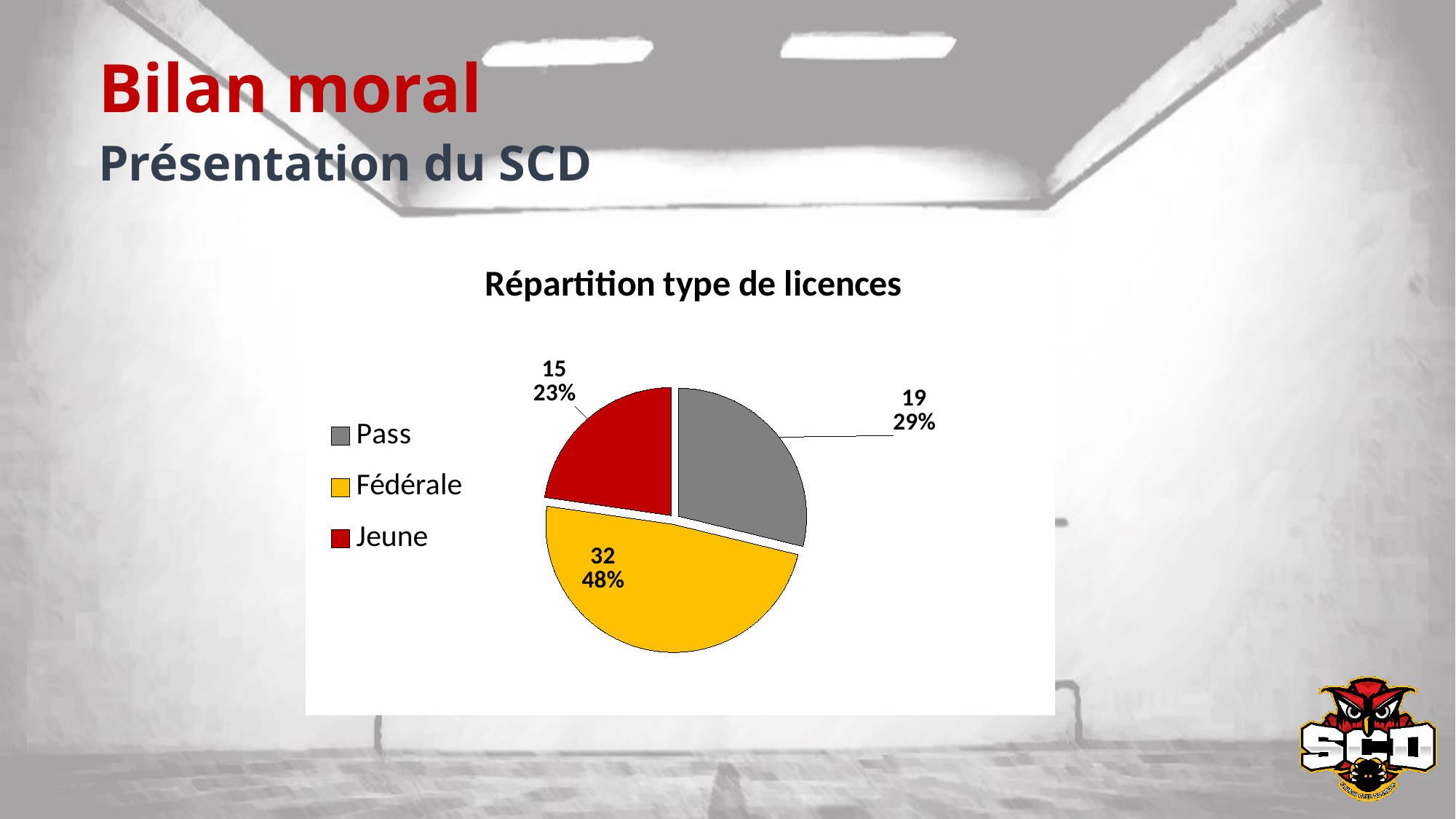
What is the value for Jeune? 15 Which licence type has the largest slice? Fédérale What type of chart is shown on the slide? pie chart Which licence type has the smallest slice? Jeune How many entries does the legend list? 3 How many slices does the pie chart have? 3 What share of the pie does Fédérale represent? 48% What share of the pie does Jeune represent? 23% What is the difference between the values for Fédérale and Pass? 13 What is the value for Pass? 19 What is the title of the chart? Répartition type de licences What is the value for Fédérale? 32